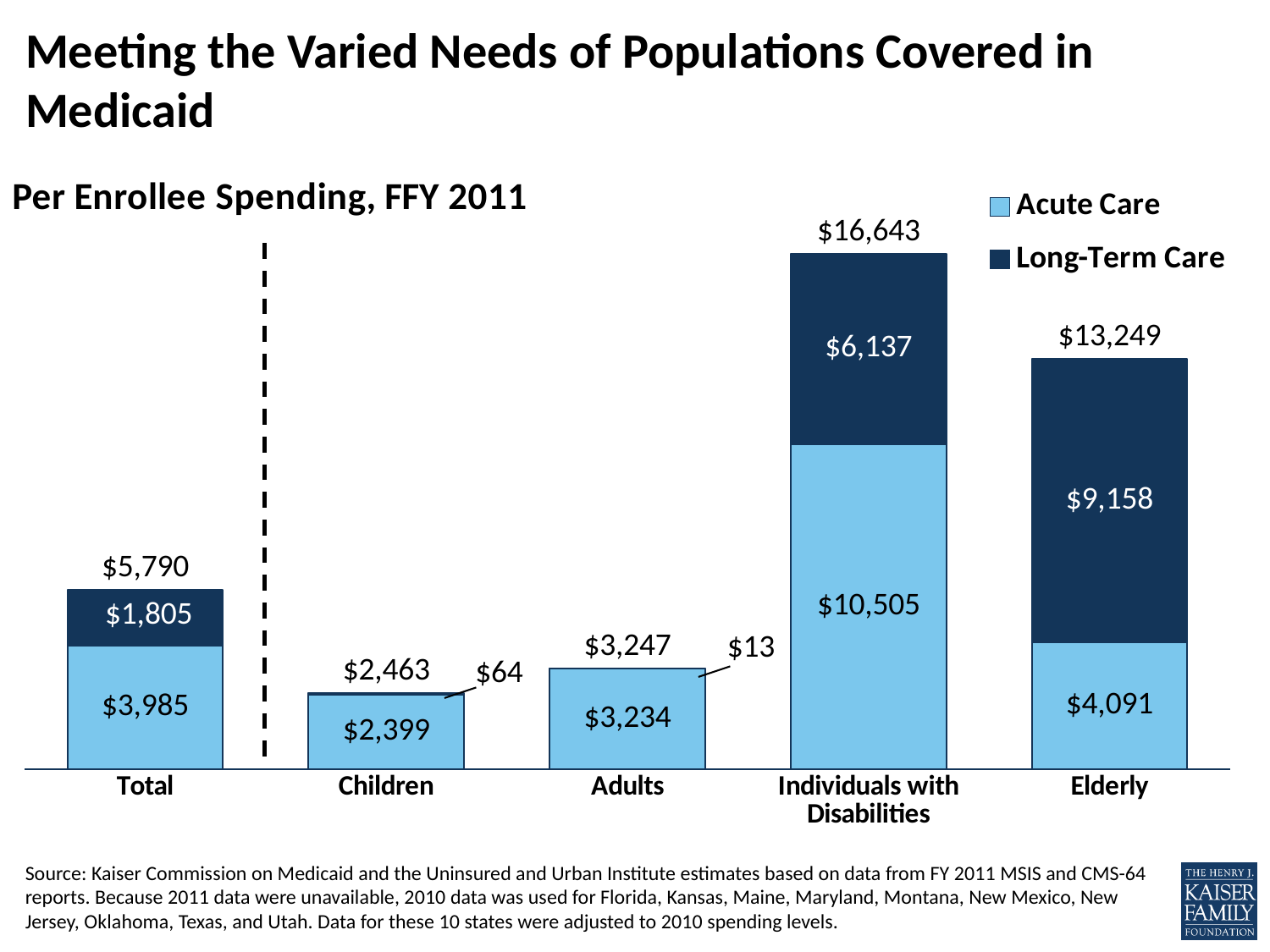
What kind of chart is shown on the slide? Stacked bar chart Which category has the highest total per enrollee spending? Individuals with Disabilities What is the Long-Term Care spending per enrollee for Children? $64 What is the total per enrollee spending for Adults? $3,247 How many series does the legend list? 2 How many categories are shown on the x axis? 5 Which series is shown in dark blue in the legend? Long-Term Care What is the difference between the total per enrollee spending for Individuals with Disabilities and for the Elderly? $3,394 Which category has the lowest total per enrollee spending? Children Which is larger for the Elderly: Acute Care spending or Long-Term Care spending? Long-Term Care What is the Acute Care spending per enrollee for Individuals with Disabilities? $10,505 What is the Long-Term Care spending per enrollee for the Elderly? $9,158